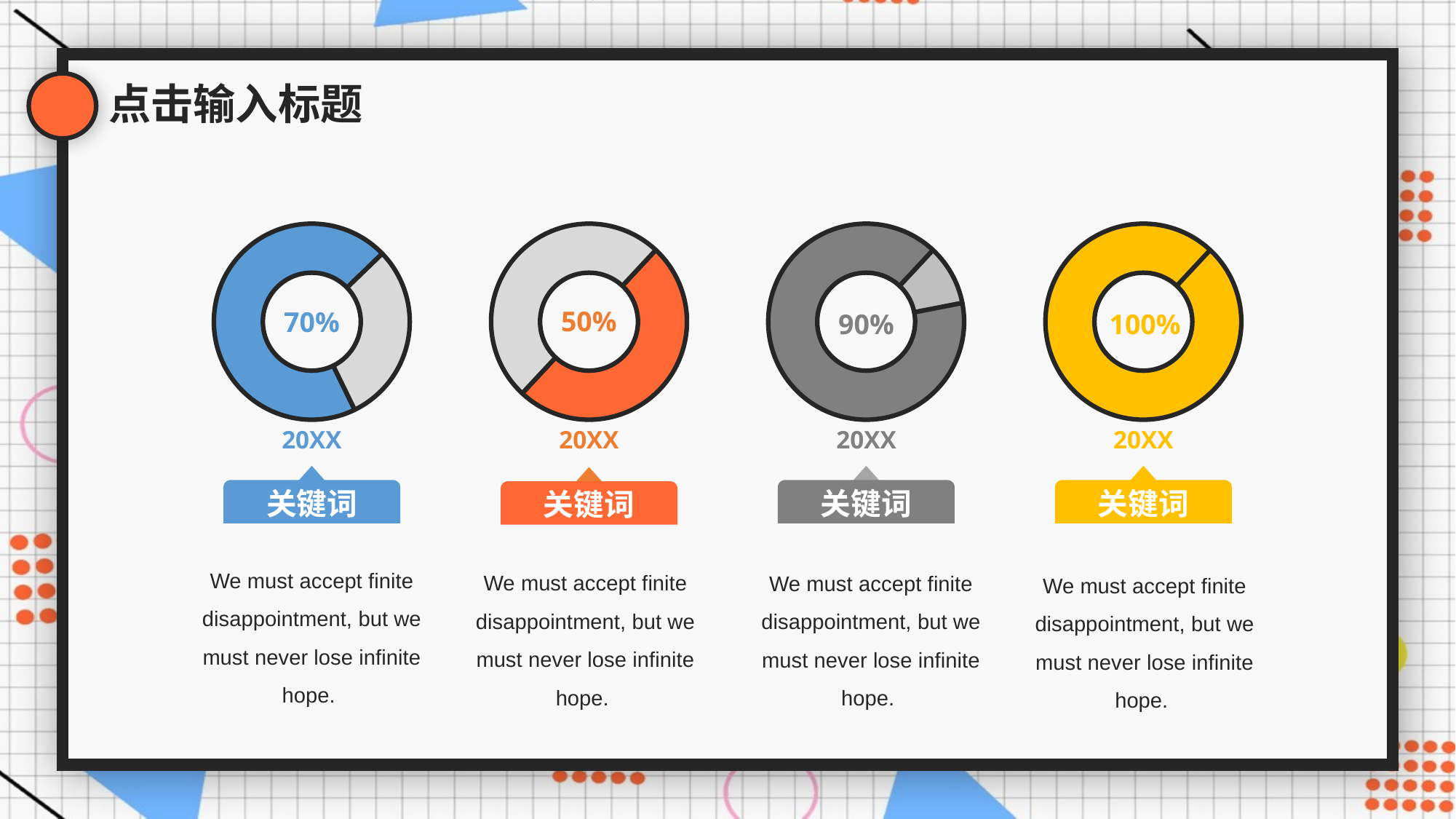
What percentage is shown in the centre of the second (orange) donut chart? 50% Which of the four donut charts shows the highest percentage? The rightmost (yellow) chart, 100% Which is larger: the percentage in the leftmost (blue) donut chart or the percentage in the second (orange) donut chart? The leftmost (blue) chart, 70% What percentage is shown in the centre of the leftmost (blue) donut chart? 70% What colour is the filled portion of the donut chart that shows 90%? Grey What is the difference between the percentage in the rightmost (yellow) donut chart and the percentage in the second (orange) donut chart? 50% How many donut charts are shown on the slide? 4 What is the difference between the percentage in the third (grey) donut chart and the percentage in the leftmost (blue) donut chart? 20% Which of the four donut charts shows the lowest percentage? The second (orange) chart, 50% What kind of chart is used for each of the four figures on the slide? Donut (pie) chart What percentage is shown in the centre of the rightmost (yellow) donut chart? 100% What percentage is shown in the centre of the third (grey) donut chart? 90%